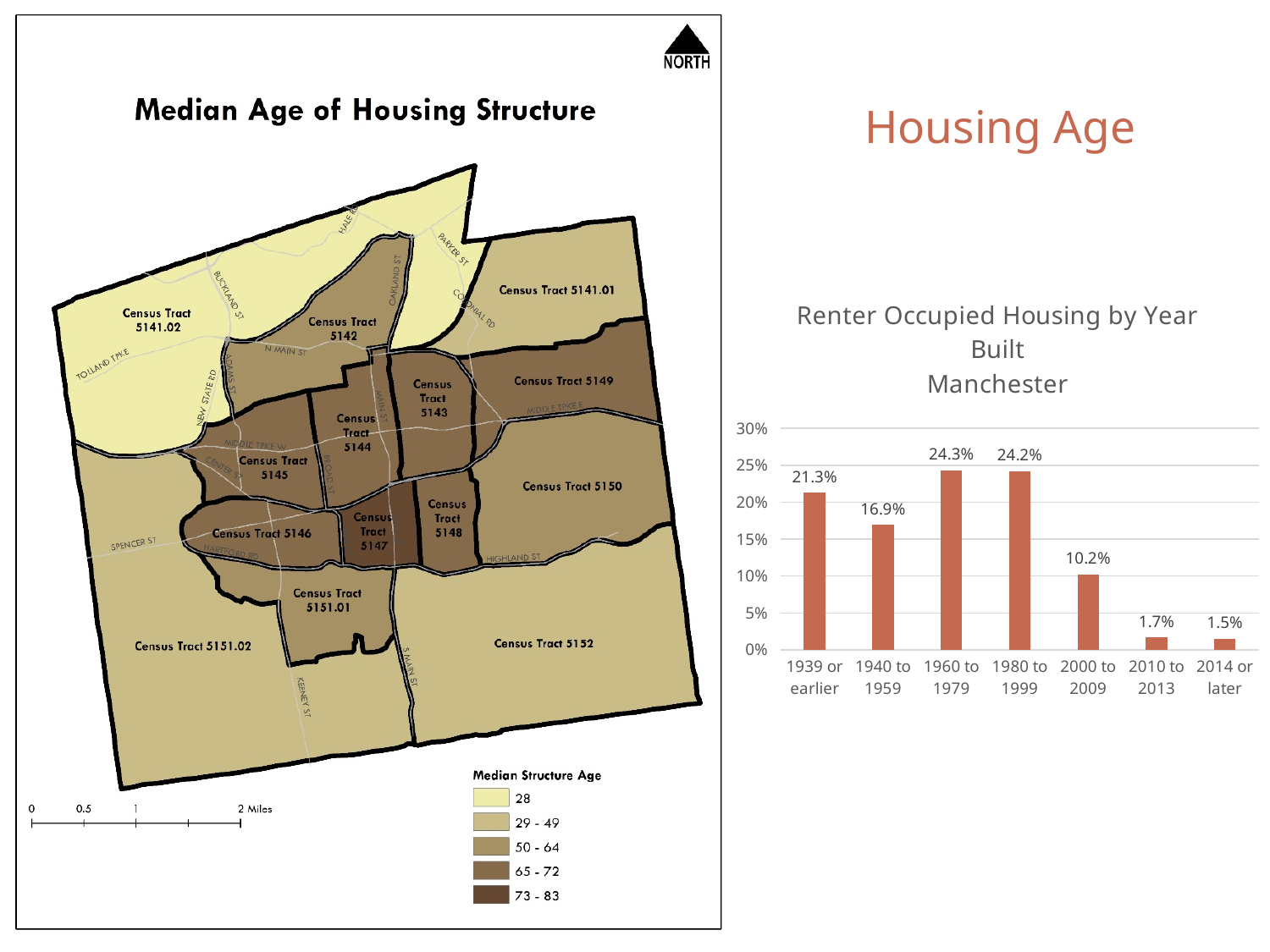
In the 'Renter Occupied Housing by Year Built' chart, what percentage of renter occupied housing was built in 1939 or earlier? 21.3% What kind of chart is the 'Renter Occupied Housing by Year Built' chart? bar chart In the 'Renter Occupied Housing by Year Built' chart, which is larger: the value for 1939 or earlier or the value for 1940 to 1959? 1939 or earlier In the 'Renter Occupied Housing by Year Built' chart, which year-built category has the lowest percentage? 2014 or later In the 'Renter Occupied Housing by Year Built' chart, what is the difference between the values for 1980 to 1999 and 2000 to 2009? 14.0% In the 'Renter Occupied Housing by Year Built' chart, what is the value for 2000 to 2009? 10.2% In the 'Renter Occupied Housing by Year Built' chart, which year-built category has the highest percentage? 1960 to 1979 Which town is named in the title of the 'Renter Occupied Housing by Year Built' chart? Manchester In the 'Renter Occupied Housing by Year Built' chart, do the values rise or fall from 1980 to 1999 onward to 2014 or later? fall In the 'Renter Occupied Housing by Year Built' chart, is the value for 2010 to 2013 greater or less than 5%? less In the 'Renter Occupied Housing by Year Built' chart, what is the value for 1940 to 1959? 16.9% How many year-built categories are shown in the 'Renter Occupied Housing by Year Built' chart? 7